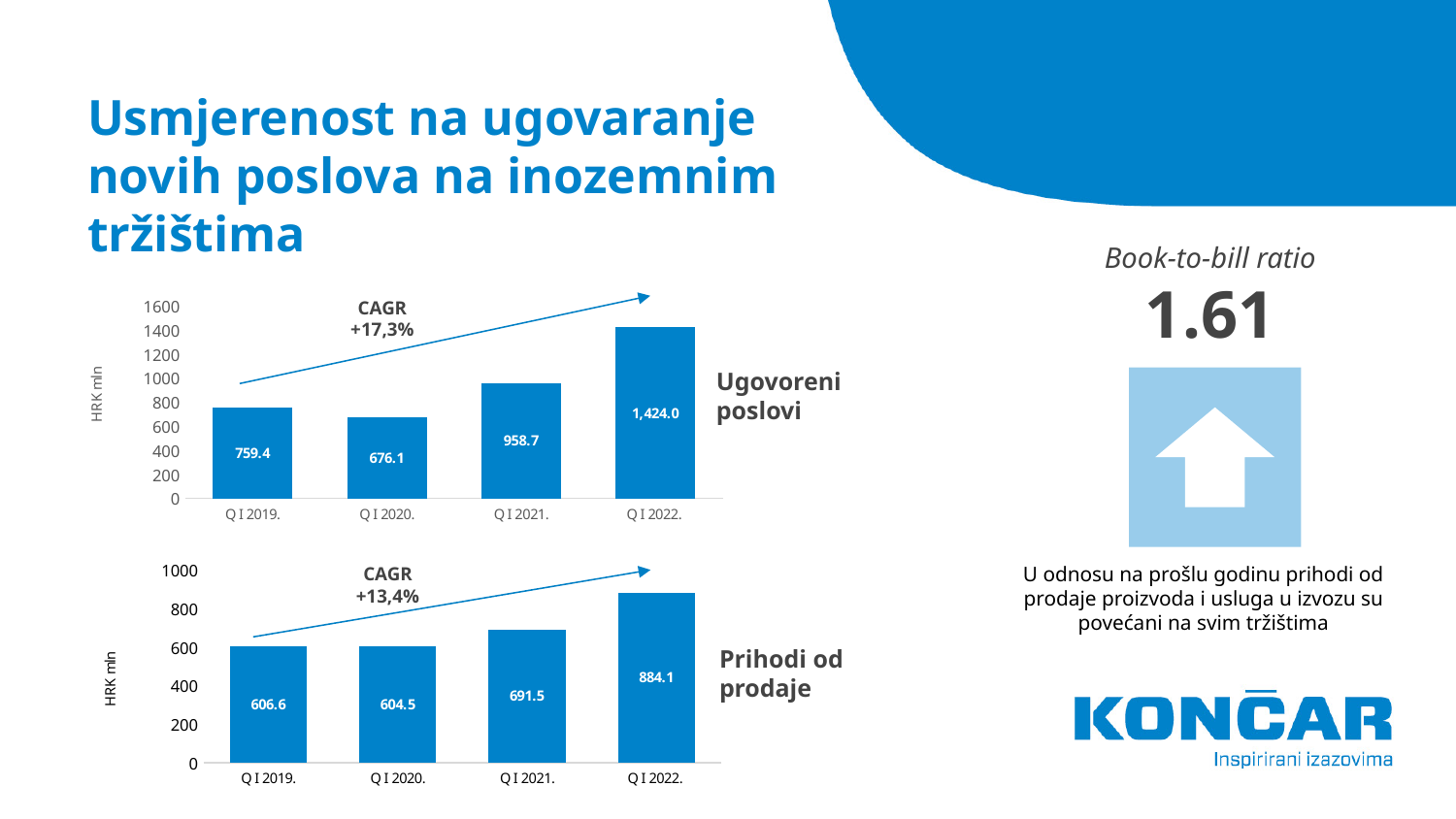
In the Prihodi od prodaje chart, which quarter has the highest value? Q I 2022. How many quarters are shown in the Prihodi od prodaje chart? 4 In the Prihodi od prodaje chart, what is the value for Q I 2022.? 884.1 In the Ugovoreni poslovi chart, what is the value for Q I 2022.? 1,424.0 What type of chart is the Ugovoreni poslovi chart? bar chart In the Ugovoreni poslovi chart, which quarter has the lowest value? Q I 2020. In the Ugovoreni poslovi chart, which is larger, the value for Q I 2019. or Q I 2021.? Q I 2021. In the Prihodi od prodaje chart, what is the value for Q I 2021.? 691.5 In the Prihodi od prodaje chart, what is the difference between the values for Q I 2022. and Q I 2021.? 192.6 In the Ugovoreni poslovi chart, what is the value for Q I 2020.? 676.1 In the Ugovoreni poslovi chart, what is the difference between the values for Q I 2022. and Q I 2021.? 465.3 In the Ugovoreni poslovi chart, is the value for Q I 2022. greater or less than 1200? greater